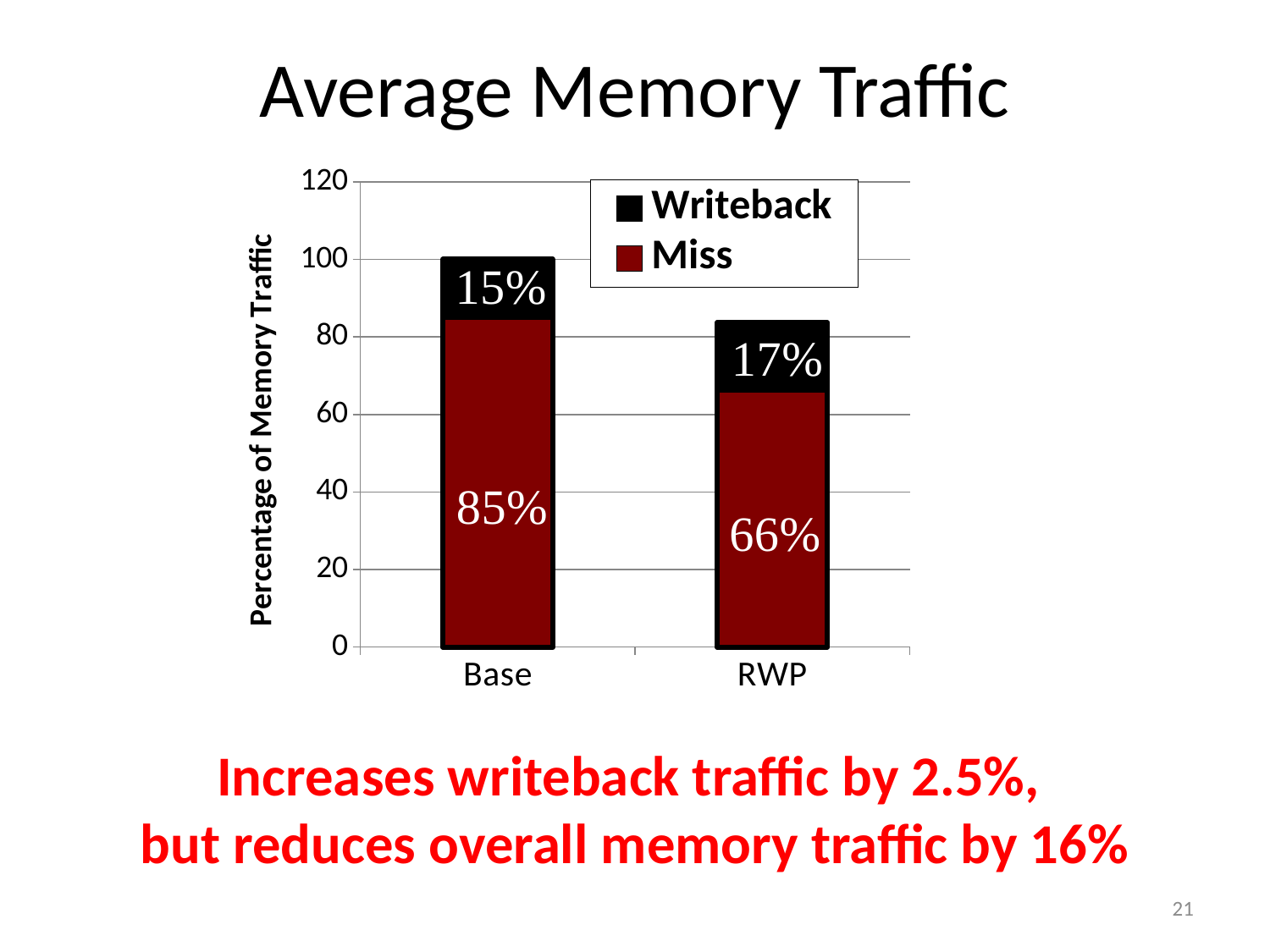
What is the title of the chart? Average Memory Traffic How many series does the legend list? 2 How many categories are shown on the x axis? 2 What is the Writeback value for Base? 15% What is the total of the stacked bar for Base? 100% What kind of chart is shown on the slide? Stacked bar chart What is the Miss value for RWP? 66% What is the Miss value for Base? 85% What is the difference between the Miss values for Base and RWP? 19% What is the Writeback value for RWP? 17% Which category has the higher Miss value, Base or RWP? Base What is the total of the stacked bar for RWP? 83%